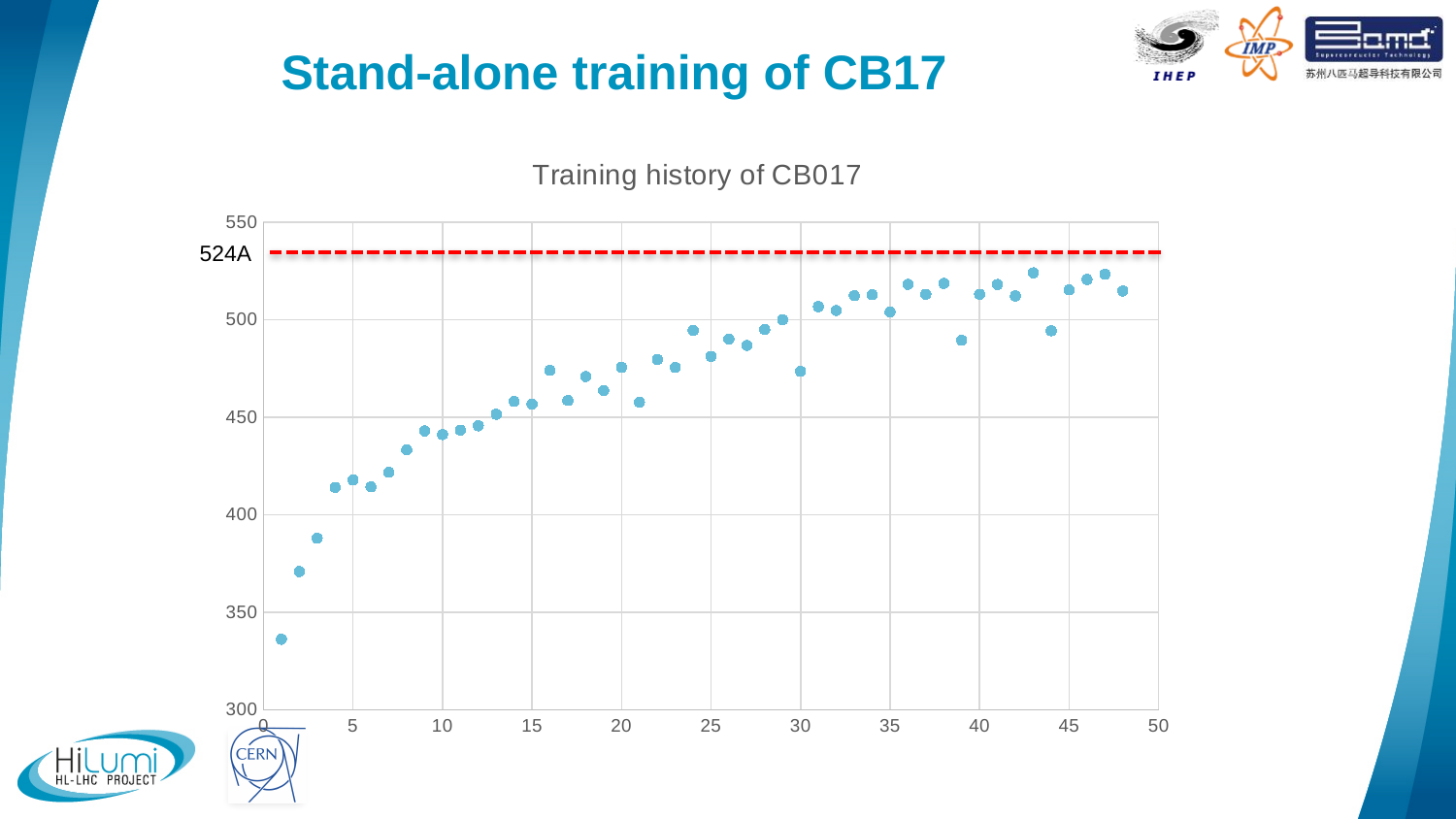
Is the value of the point at x = 2 greater or less than 350? greater Is the value of the point at x = 10 greater or less than 450? less What value is labelled on the red dashed horizontal line? 524A Do the plotted values generally rise or fall along the x axis? Rise Is the value of the point at x = 20 greater or less than 500? less What kind of chart is shown on the slide? Scatter chart At which x value does the lowest point on the chart occur? 1 What is the title of the chart? Training history of CB017